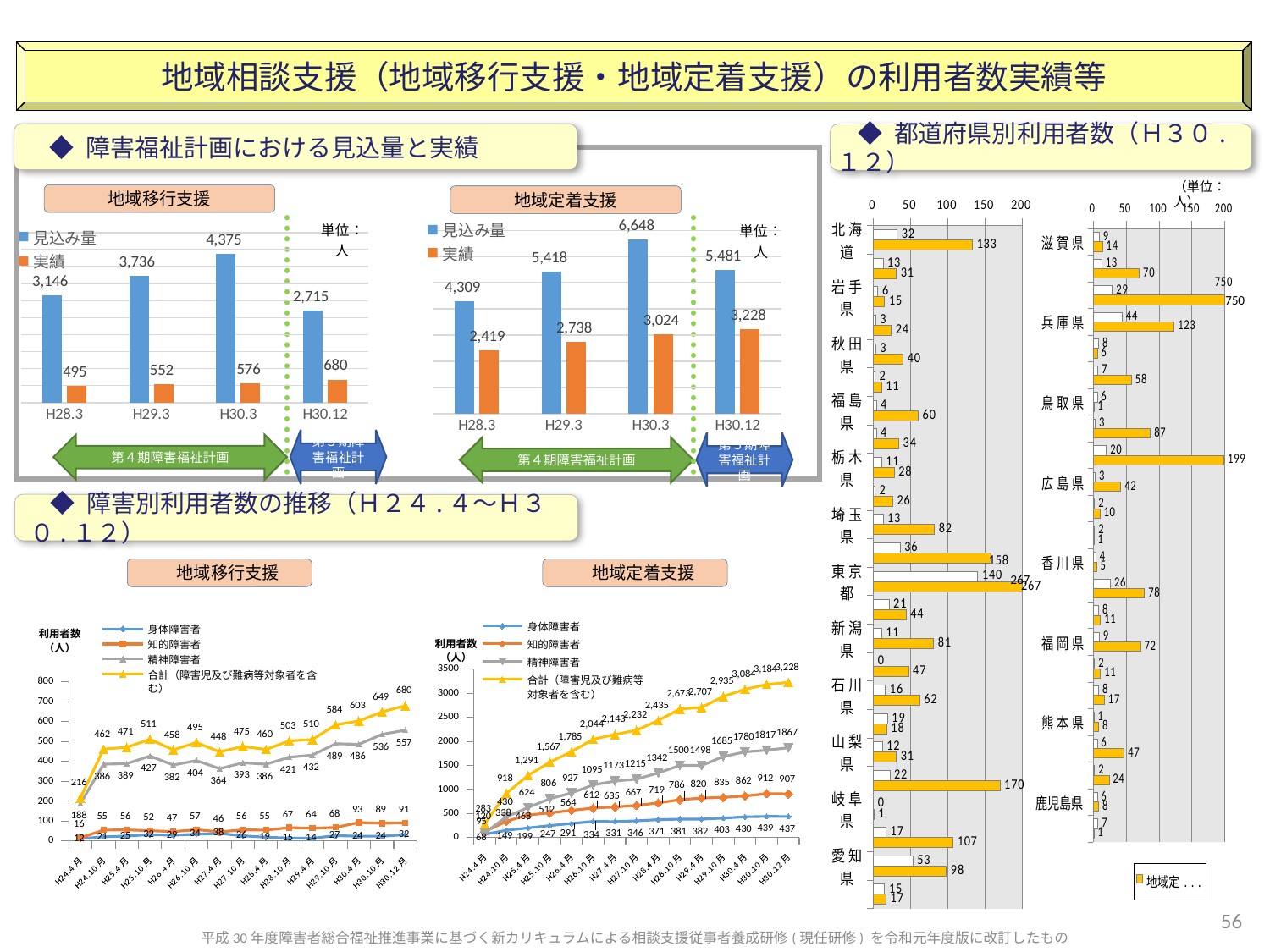
In the 地域移行支援 bar chart under 障害福祉計画における見込量と実績, what is the 見込み量 for H30.3? 4,375 In the 地域定着支援 line chart under 障害別利用者数の推移, how many series does the legend list? 4 In the 地域定着支援 bar chart under 障害福祉計画における見込量と実績, what is the 実績 for H30.12? 3,228 In the 地域移行支援 bar chart under 障害福祉計画における見込量と実績, how many series does the legend list? 2 In the 地域定着支援 bar chart under 障害福祉計画における見込量と実績, which is larger at H29.3, 見込み量 or 実績? 見込み量 What kind of chart is the 地域移行支援 chart under 障害福祉計画における見込量と実績? Bar chart In the 地域定着支援 bar chart under 障害福祉計画における見込量と実績, which period has the highest 見込み量? H30.3 In the 地域移行支援 bar chart under 障害福祉計画における見込量と実績, what is the difference between 見込み量 and 実績 at H28.3? 2,651 In the 地域移行支援 line chart under 障害別利用者数の推移, does the 合計 line rise or fall from H29.4月 to H30.12月? Rise In the 地域定着支援 line chart under 障害別利用者数の推移, what is the 合計 value at H30.12月? 3,228 In the 地域移行支援 line chart under 障害別利用者数の推移, what is the 合計 value at H24.4月? 216